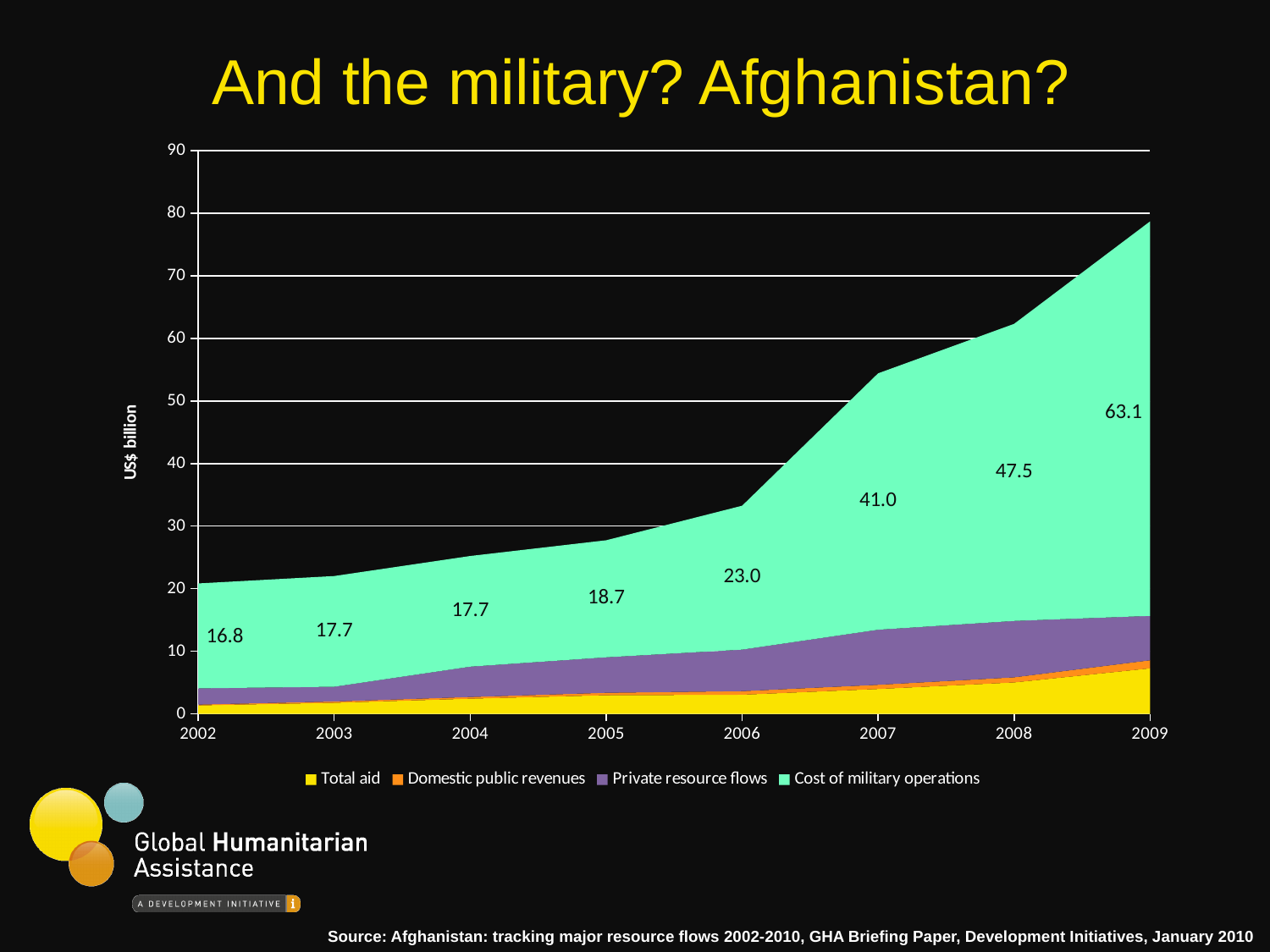
In which year is the Cost of military operations highest? 2009 How many series does the legend list? 4 What is the value for Cost of military operations in 2009? 63.1 In which year is the Cost of military operations lowest? 2002 Which is larger, the Cost of military operations in 2006 or in 2007? 2007 What is the unit shown on the y axis? US$ billion What kind of chart is shown on the slide? Stacked area chart What is the value for Cost of military operations in 2002? 16.8 Is the total stacked value for 2009 greater or less than 70? greater What is the value for Cost of military operations in 2007? 41.0 What is the difference between the Cost of military operations in 2009 and in 2008? 15.6 How many years are plotted on the x axis? 8